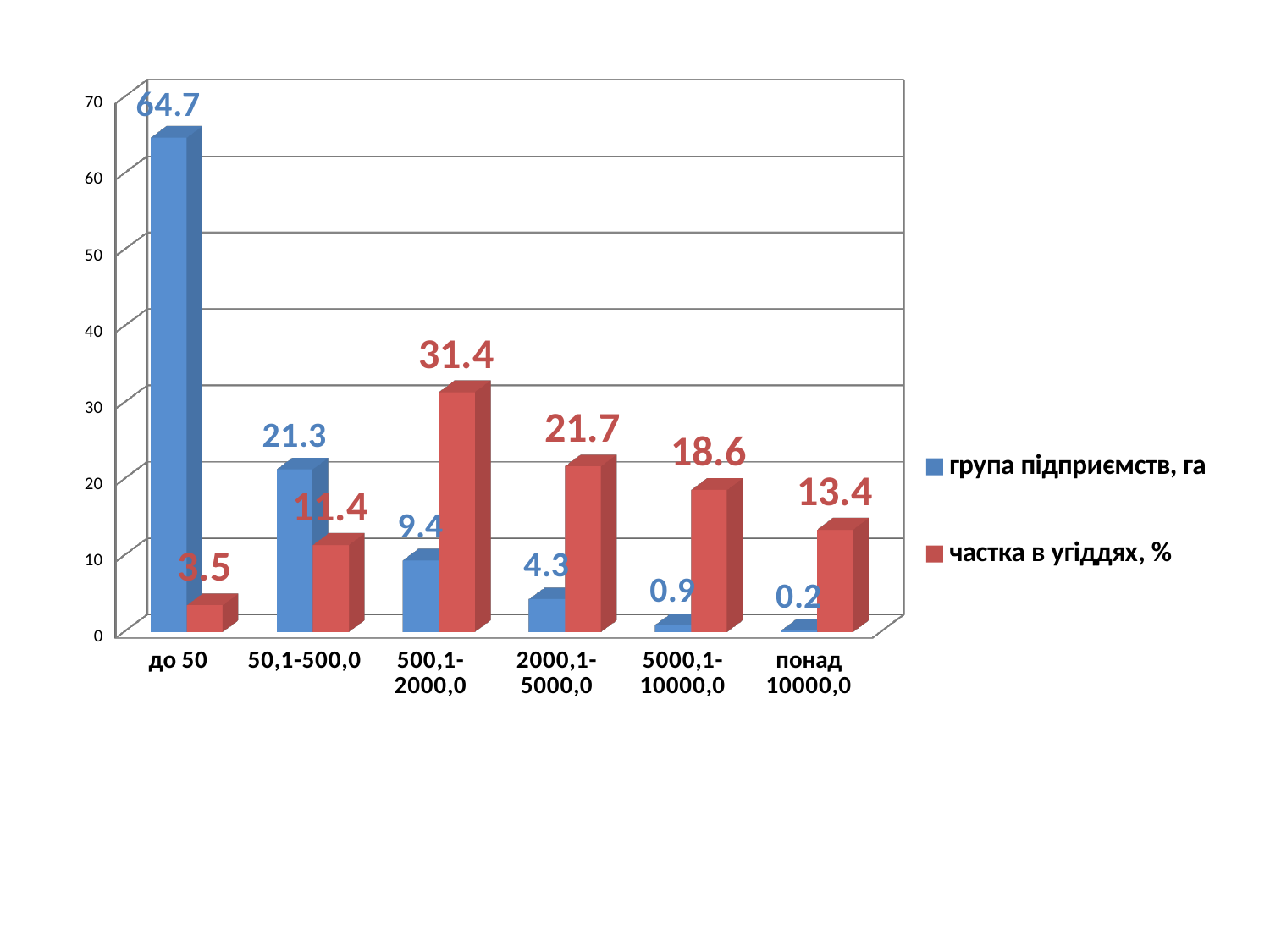
What kind of chart is shown on the slide? bar chart What is the value of "частка в угіддях, %" for the category "500,1-2000,0"? 31.4 What is the value of "група підприємств, га" for the category "до 50"? 64.7 Which category has the highest value for "частка в угіддях, %"? 500,1-2000,0 How many series does the legend list? 2 Which category has the lowest value for "група підприємств, га"? понад 10000,0 How many categories are shown on the x axis? 6 What colour are the bars for the series "частка в угіддях, %"? red What is the value of "частка в угіддях, %" for the category "понад 10000,0"? 13.4 What is the difference between the "група підприємств, га" value and the "частка в угіддях, %" value for the category "до 50"? 61.2 For the category "2000,1-5000,0", which series has the larger value: "група підприємств, га" or "частка в угіддях, %"? частка в угіддях, % Do the values of "група підприємств, га" rise or fall from left to right along the x axis? fall